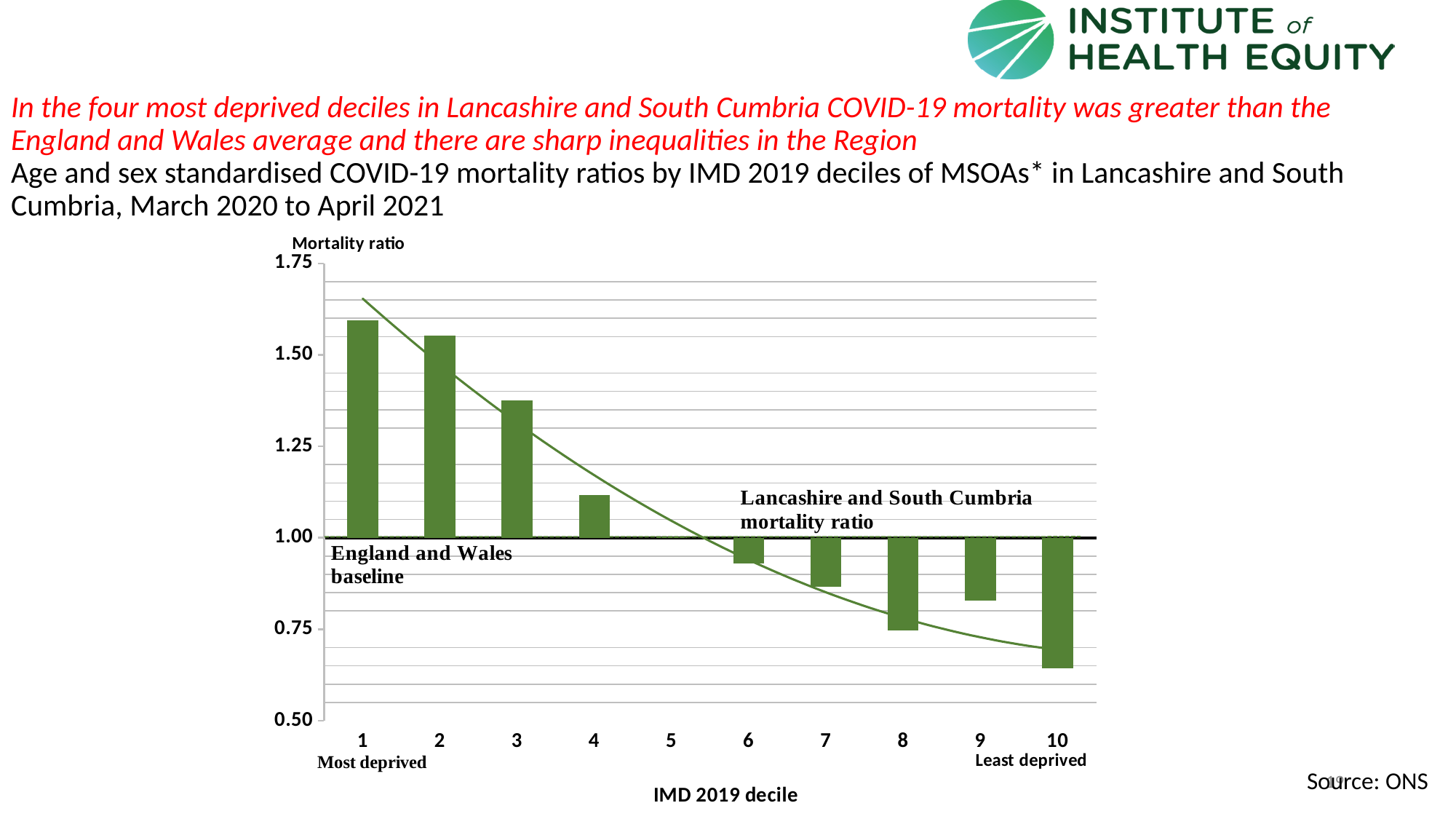
Is the mortality ratio for decile 4 greater or less than 1.00? greater Is the mortality ratio for decile 10 greater or less than 0.75? less What kind of chart is shown on the slide? bar chart How many IMD 2019 deciles are shown on the x axis of the chart? 10 Is the mortality ratio for decile 3 greater or less than 1.25? greater Which IMD decile has the lowest mortality ratio in the chart? 10 What value does the horizontal line labelled 'England and Wales baseline' sit at on the y axis? 1.00 Do the mortality ratios generally rise or fall as the IMD decile increases from 1 to 10? fall Which has the higher mortality ratio, decile 3 or decile 4? decile 3